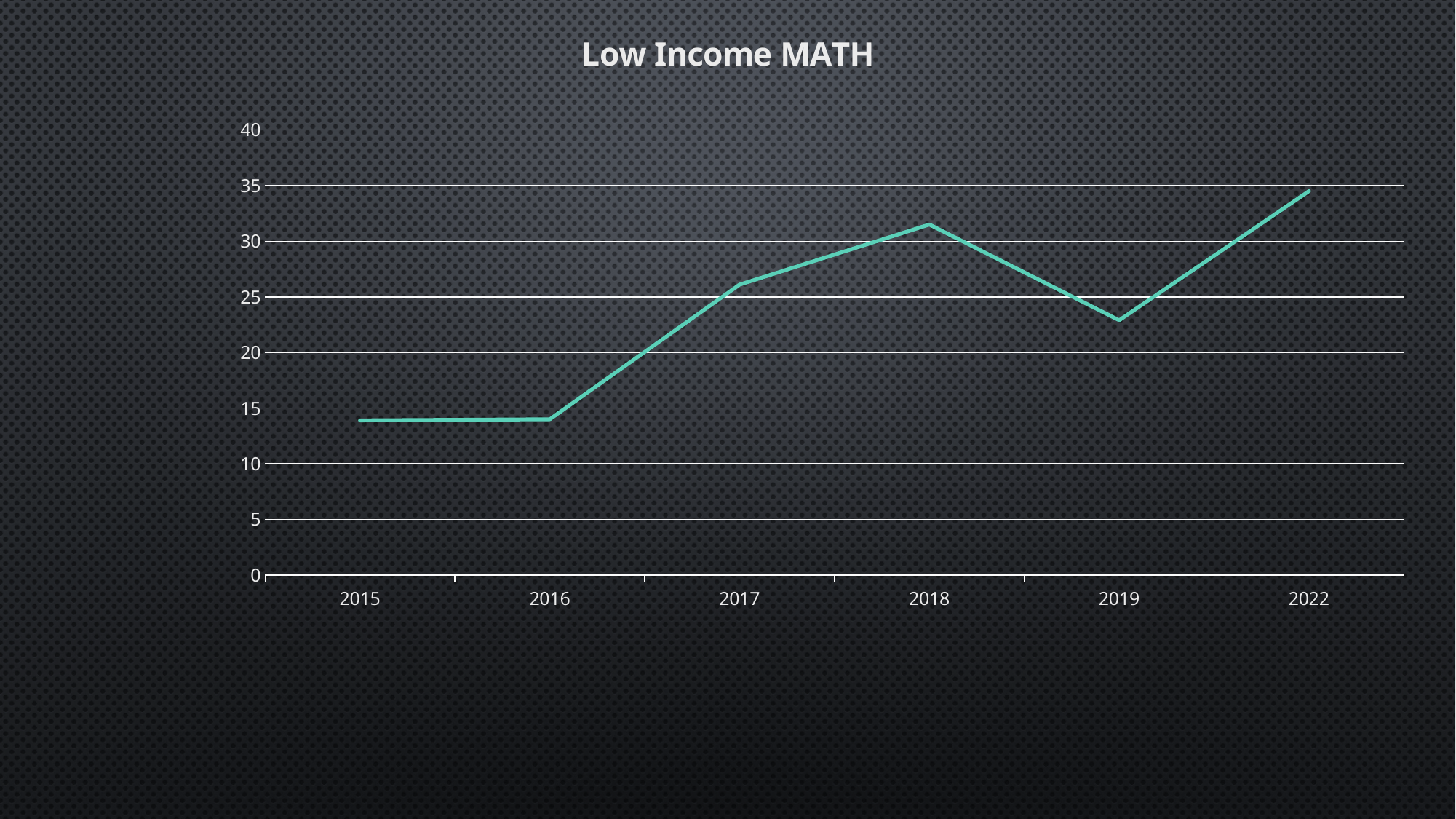
Is the value for 2018 greater or less than 30? greater Does the value rise or fall from 2016 to 2018? rise What is the title of the chart? Low Income MATH Is the value for 2022 greater or less than 30? greater Is the value for 2017 greater or less than 25? greater Which is larger, the value for 2018 or the value for 2019? 2018 What kind of chart is shown on the slide? line chart How many years are plotted on the x axis? 6 Does the value rise or fall from 2018 to 2019? fall Which year has the highest value? 2022